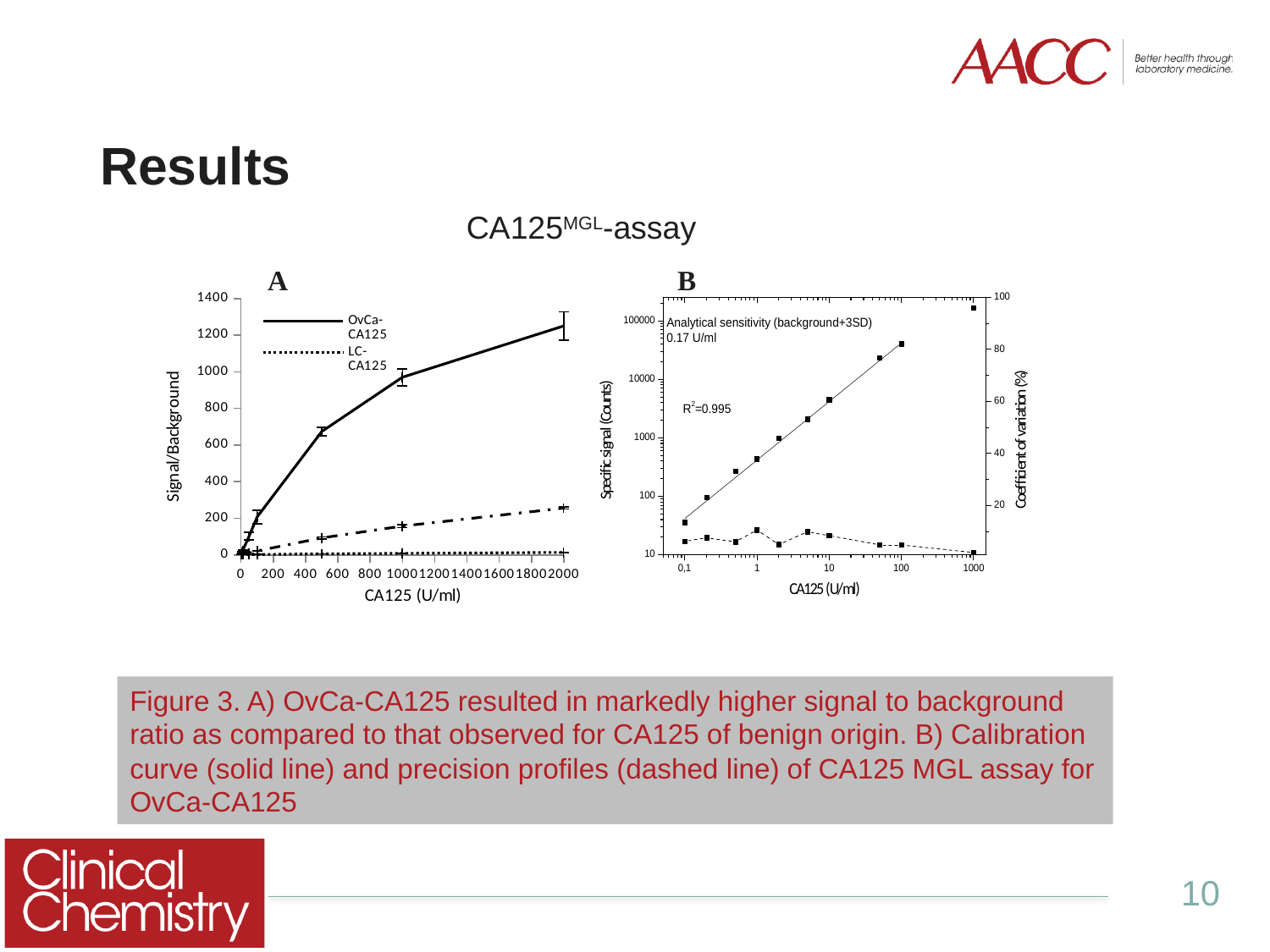
In chart A, which series reaches the highest Signal/Background value? OvCa-CA125 In chart A, is the Signal/Background value for OvCa-CA125 at 500 U/ml greater or less than 600? greater How many series does the legend of chart A list? 2 In chart A, does the OvCa-CA125 Signal/Background value rise or fall as CA125 concentration increases? rise In chart A, is the Signal/Background value for OvCa-CA125 at 2000 U/ml greater or less than 1000? greater What kind of chart is chart A on the slide? line chart What R² value is printed on chart B? R²=0.995 In chart A, is the Signal/Background value for LC-CA125 at 2000 U/ml greater or less than 200? less In chart B, does the calibration curve (solid line) rise or fall as CA125 concentration increases? rise What is the label of the left y-axis of chart B? Specific signal (Counts) In chart A, at 2000 U/ml, which series has the larger Signal/Background value, OvCa-CA125 or LC-CA125? OvCa-CA125 What analytical sensitivity (background+3SD) is stated on chart B? 0.17 U/ml